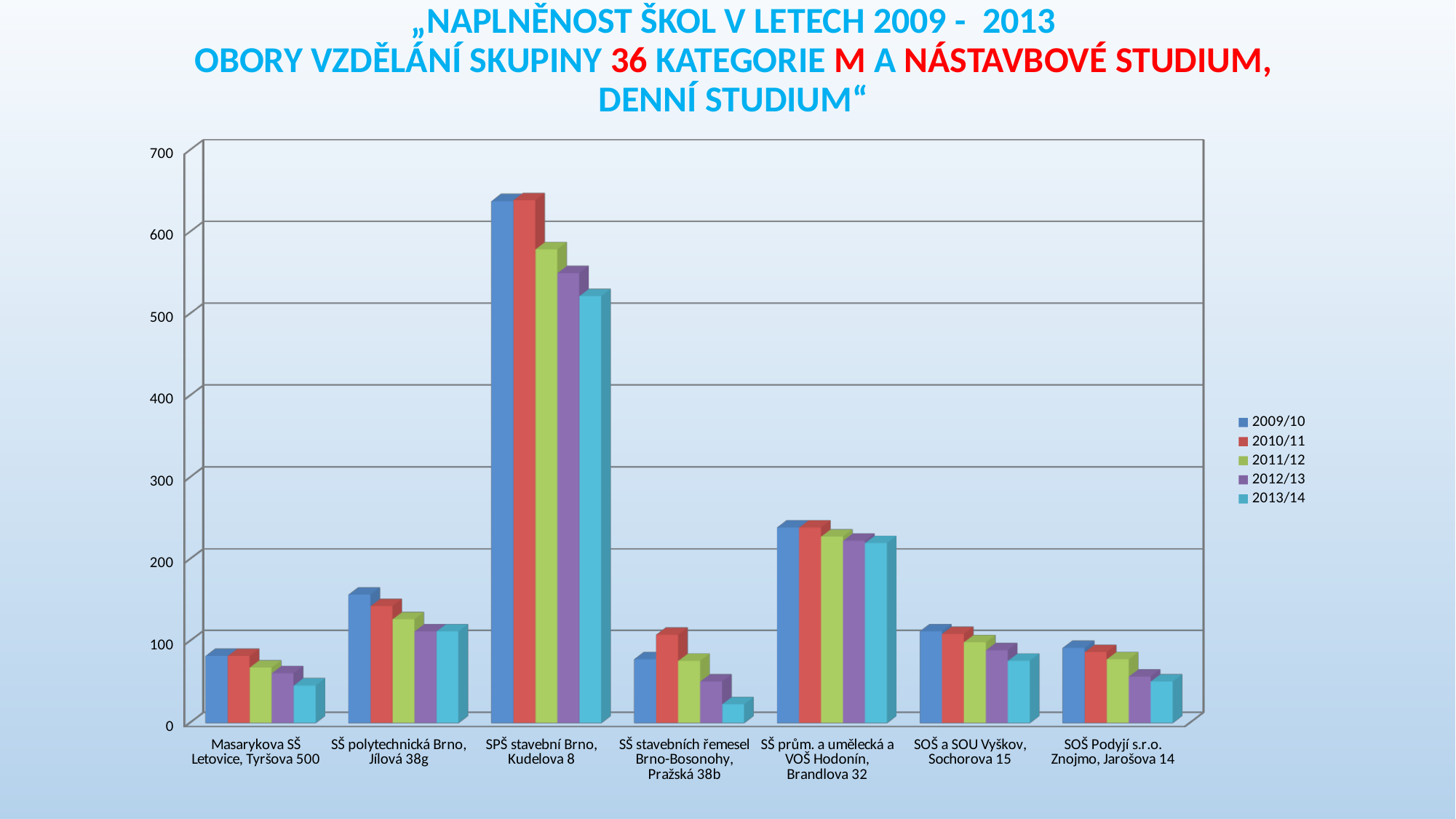
Which school has the lowest value for 2013/14? SŠ stavebních řemesel Brno-Bosonohy, Pražská 38b Is the 2009/10 value for SŠ polytechnická Brno, Jílová 38g greater or less than 100? greater Do the values for SPŠ stavební Brno, Kudelova 8 rise or fall from 2009/10 to 2013/14? fall Which school has the highest value for 2009/10? SPŠ stavební Brno, Kudelova 8 What kind of chart is shown on the slide? Bar chart For SŠ stavebních řemesel Brno-Bosonohy, Pražská 38b, which is larger: the 2009/10 value or the 2010/11 value? 2010/11 Which is larger for 2009/10: SŠ polytechnická Brno, Jílová 38g or SOŠ a SOU Vyškov, Sochorova 15? SŠ polytechnická Brno, Jílová 38g How many series does the legend of the chart list? 5 How many schools (categories) are shown on the x axis of the chart? 7 Is the 2009/10 value for SŠ prům. a umělecká a VOŠ Hodonín, Brandlova 32 greater or less than 300? less Is the 2013/14 value for SŠ stavebních řemesel Brno-Bosonohy, Pražská 38b greater or less than 100? less